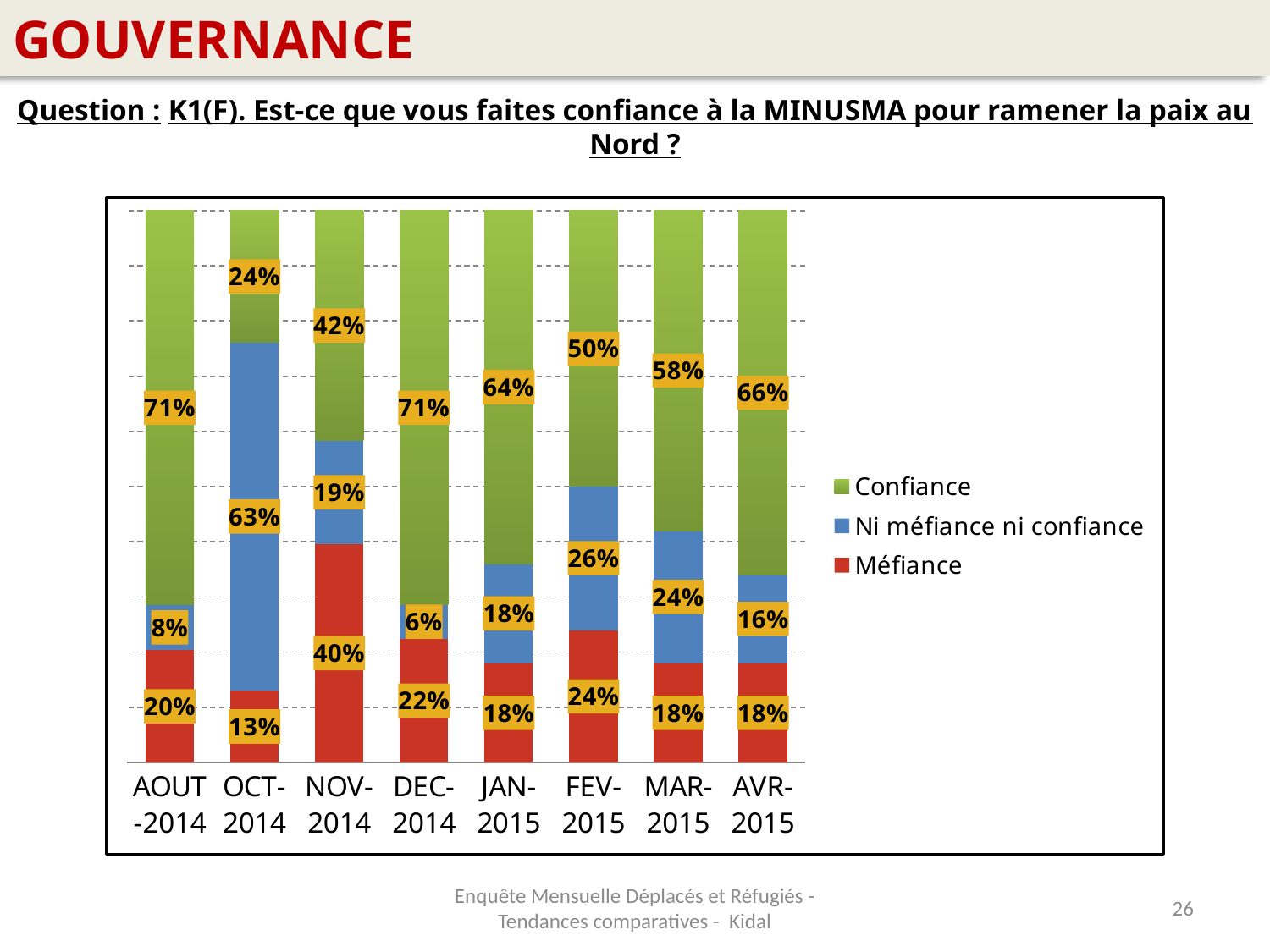
How many months are shown on the x axis? 8 How many series does the legend list? 3 In which month is the Méfiance value highest? NOV-2014 Which is larger, the Méfiance value for DEC-2014 or for MAR-2015? DEC-2014 What is the value for Méfiance in OCT-2014? 13% What is the total of the stacked bar for JAN-2015? 100% What is the value for Ni méfiance ni confiance in FEV-2015? 26% What kind of chart is shown on the slide? Stacked bar chart In which month is the Confiance value lowest? OCT-2014 What is the value for Confiance in NOV-2014? 42% In which month is the Ni méfiance ni confiance value lowest? DEC-2014 What is the difference between the Confiance values for AVR-2015 and FEV-2015? 16%